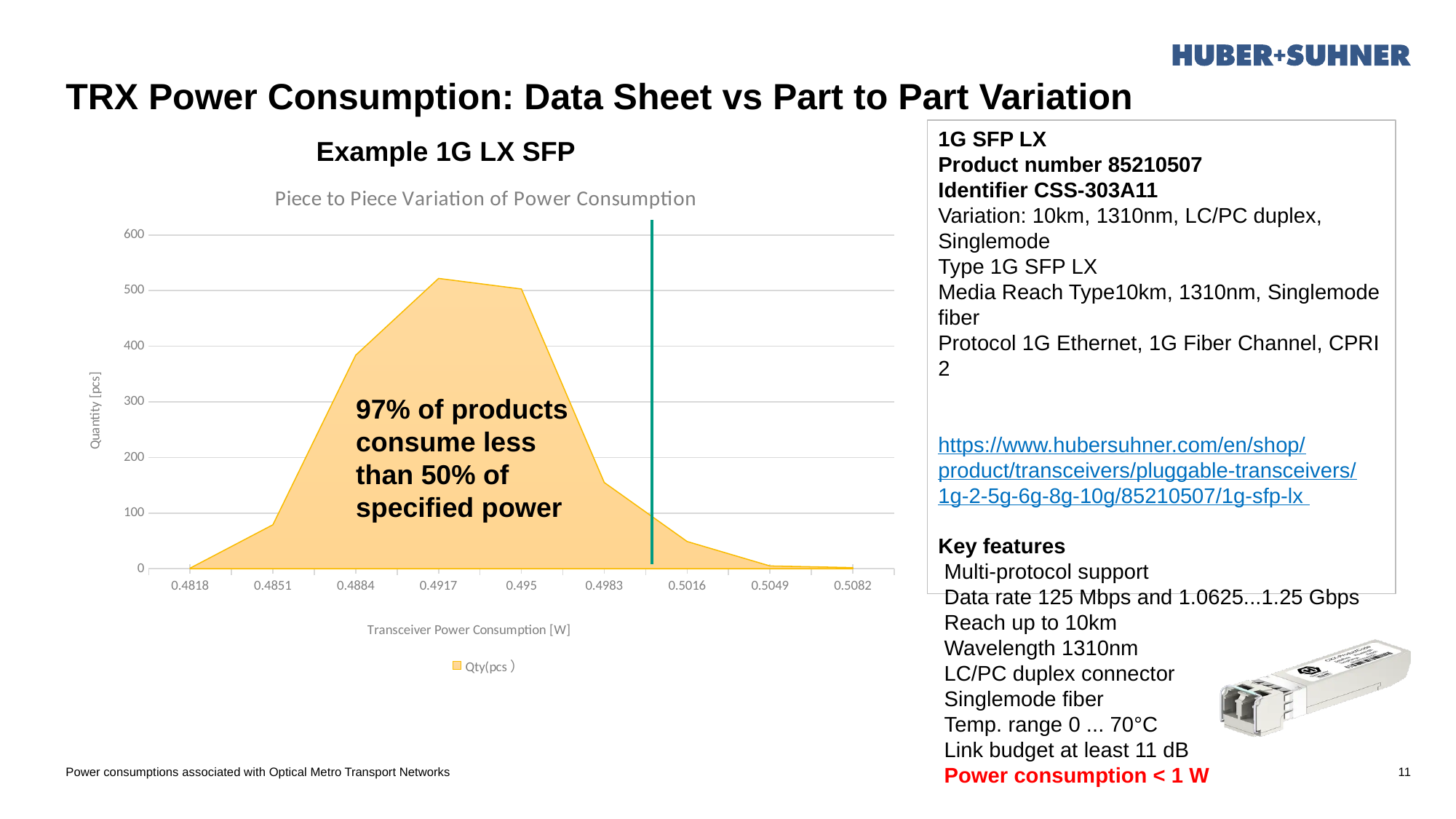
Is the quantity at 0.4917 W greater or less than 500? greater How many tick labels are shown on the x axis of the chart? 9 How does the quantity change as transceiver power consumption increases from 0.4917 W to 0.5082 W? It falls Is the quantity at 0.4983 W greater or less than 200? less Which has the larger quantity, 0.4884 W or 0.4983 W? 0.4884 At which x-axis value does the chart reach its highest quantity? 0.4917 How many series does the chart legend list? 1 What is the label of the series in the chart legend? Qty(pcs ) What is the title of the chart? Piece to Piece Variation of Power Consumption Is the quantity at 0.4851 W greater or less than 100? less What type of chart is shown on the slide? Area chart